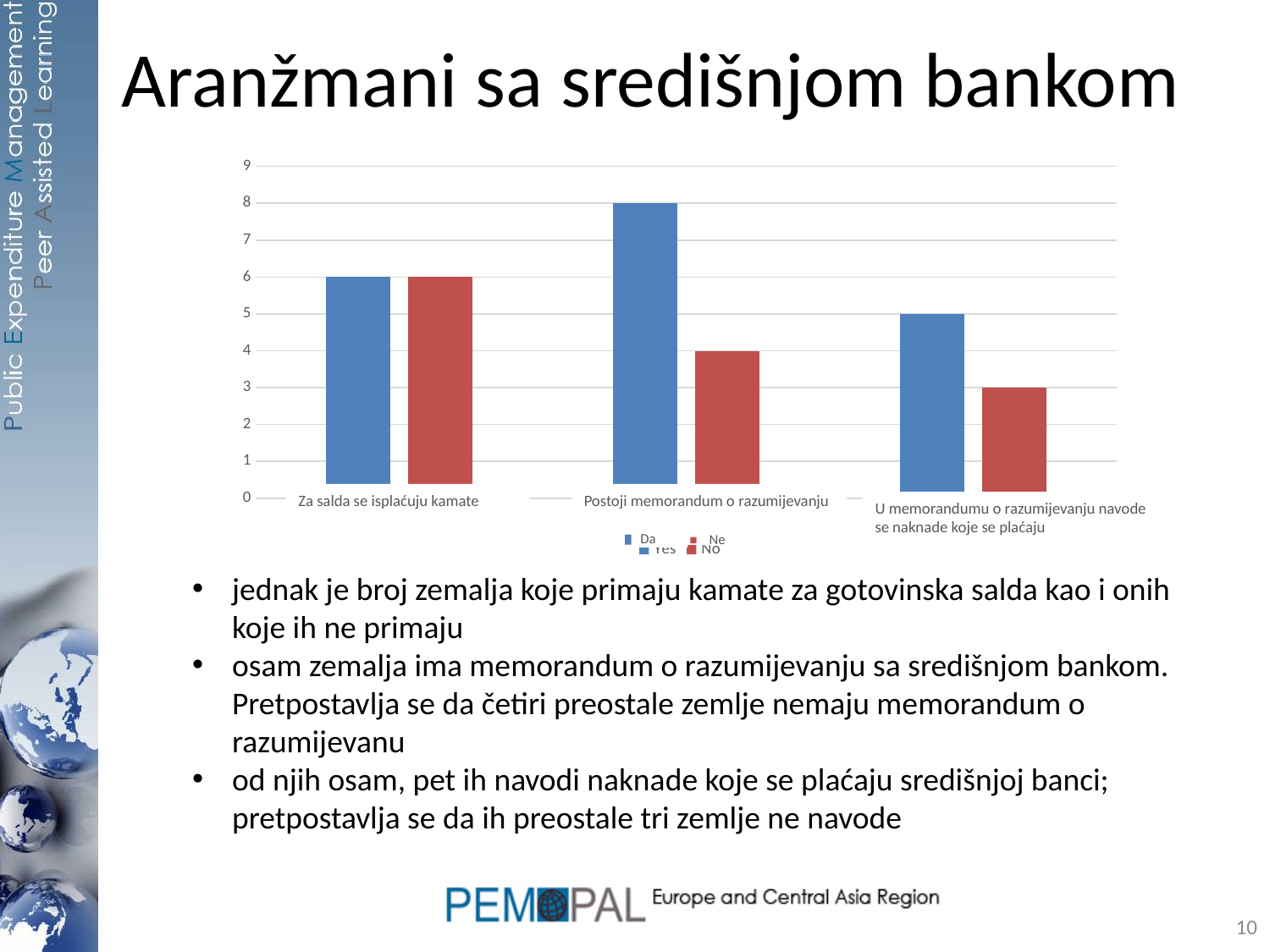
What is the value of the 'Da' bar for 'Postoji memorandum o razumijevanju'? 8 Which category has the highest 'Da' value? Postoji memorandum o razumijevanju What is the value of the 'Ne' bar for 'Postoji memorandum o razumijevanju'? 4 What is the value of the 'Da' bar for 'Za salda se isplaćuju kamate'? 6 How many categories are shown on the x axis of the chart? 3 For 'U memorandumu o razumijevanju navode se naknade koje se plaćaju', which is larger, the 'Da' bar or the 'Ne' bar? Da Which category has the lowest 'Ne' value? U memorandumu o razumijevanju navode se naknade koje se plaćaju How many series does the chart's legend list? 2 What is the value of the 'Ne' bar for 'U memorandumu o razumijevanju navode se naknade koje se plaćaju'? 3 Which colour represents the 'Ne' series in the chart? red What is the difference between the 'Da' and 'Ne' values for 'Postoji memorandum o razumijevanju'? 4 What type of chart is shown on the slide? bar chart